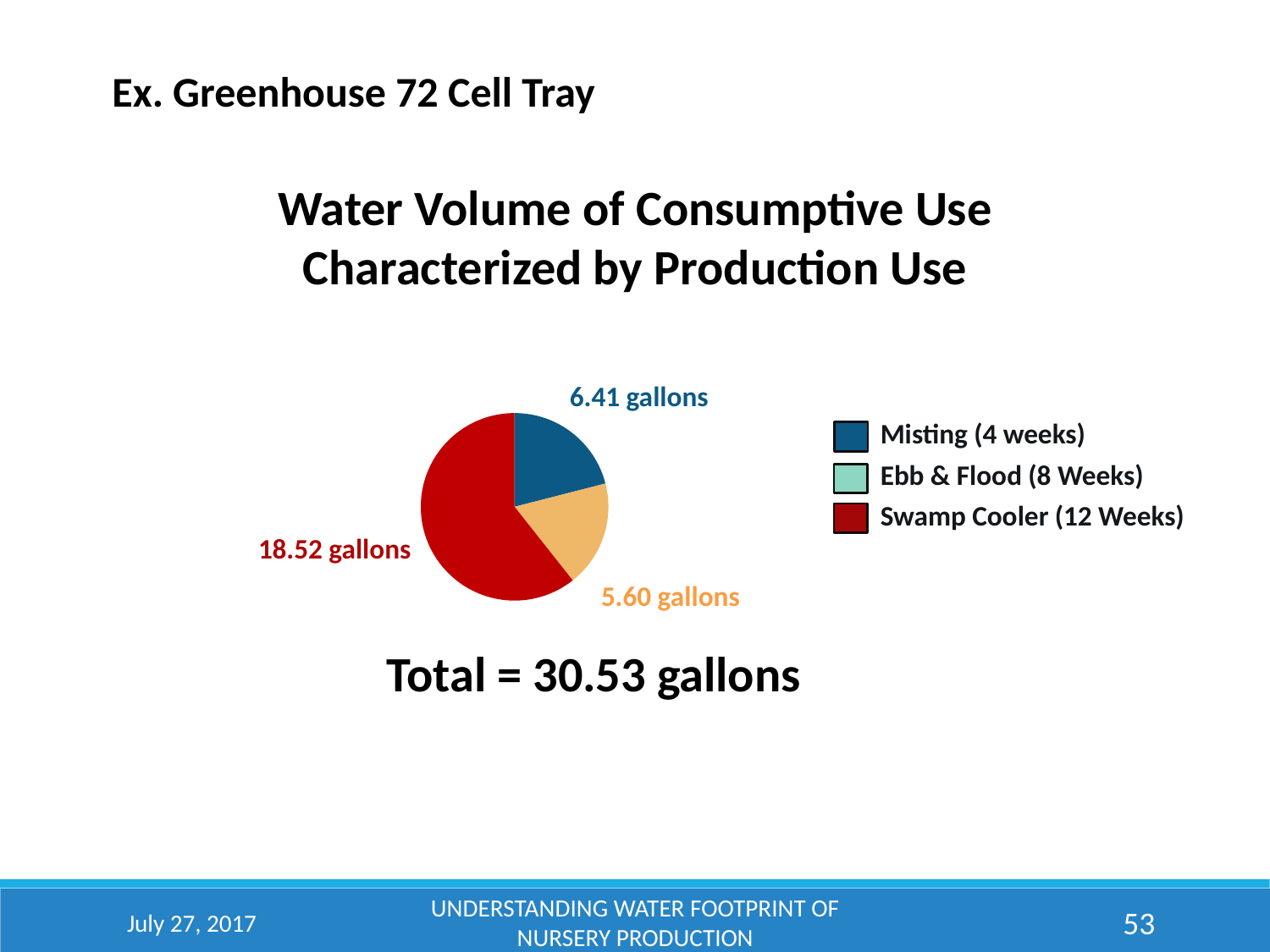
How many entries does the legend list? 3 What is the difference in water volume between Swamp Cooler (12 Weeks) and Misting (4 weeks)? 12.11 gallons What is the total water volume shown for all production uses? 30.53 gallons What is the water volume for Swamp Cooler (12 Weeks)? 18.52 gallons What type of chart is shown on the slide? Pie chart Which production use has the smallest water volume? Ebb & Flood (8 Weeks) Which uses more water, Misting (4 weeks) or Swamp Cooler (12 Weeks)? Swamp Cooler (12 Weeks) What is the title of the chart? Water Volume of Consumptive Use Characterized by Production Use How many slices does the pie chart have? 3 What is the water volume for Ebb & Flood (8 Weeks)? 5.60 gallons Which production use has the largest water volume? Swamp Cooler (12 Weeks) What is the water volume for Misting (4 weeks)? 6.41 gallons